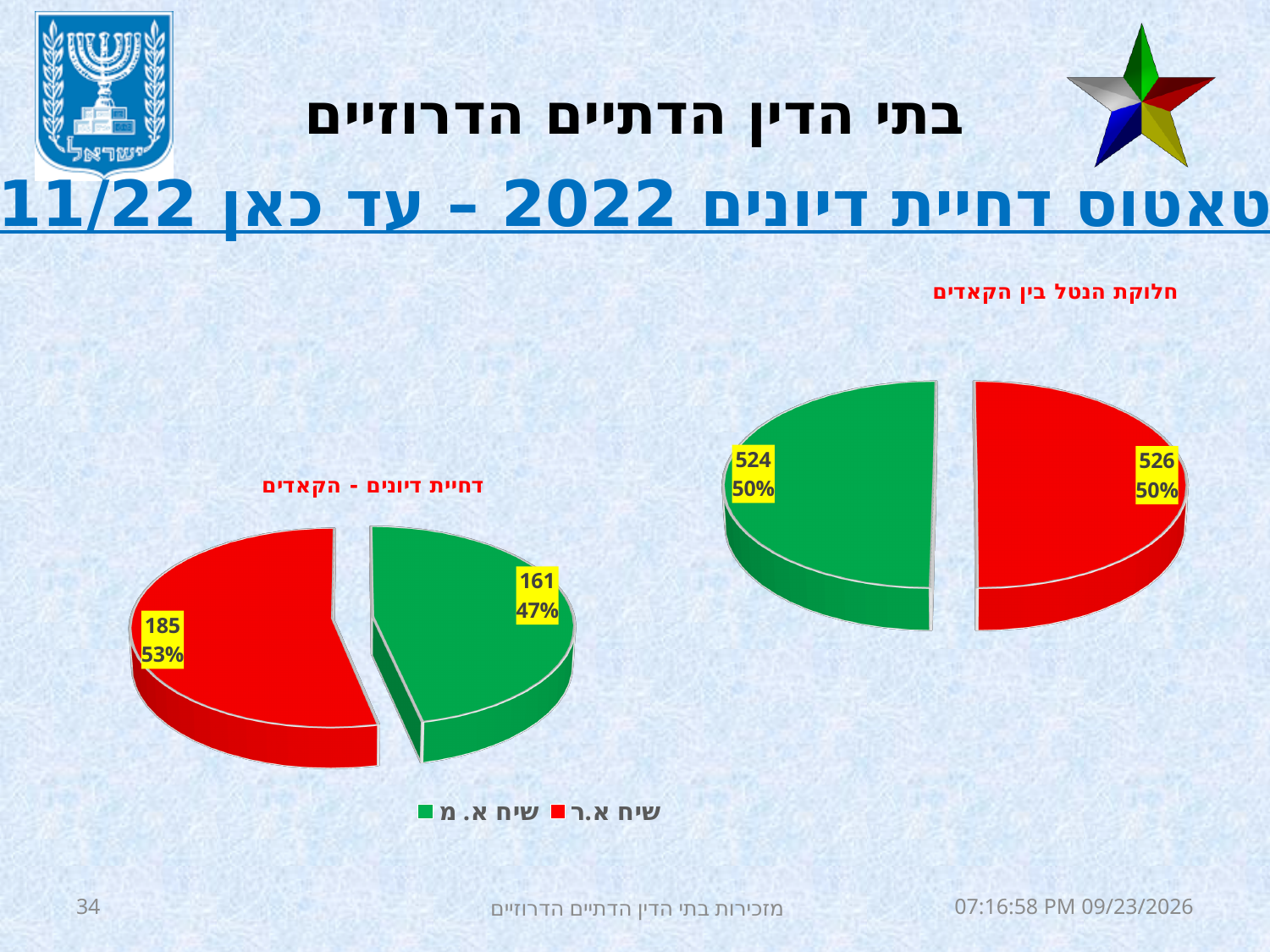
What kind of chart is the chart titled "חלוקת הנטל בין הקאדים"? Pie chart In the chart titled "חלוקת הנטל בין הקאדים", what is the total of the two slices? 1050 In the chart titled "דחיית דיונים - הקאדים", what value is shown for the red slice (שיח א.ר)? 185 In the chart titled "דחיית דיונים - הקאדים", which slice is larger, שיח א.ר or שיח א. מ? שיח א.ר In the chart titled "דחיית דיונים - הקאדים", what is the difference between the values for שיח א.ר and שיח א. מ? 24 In the chart titled "דחיית דיונים - הקאדים", what percentage is shown for the green slice (שיח א. מ)? 47% How many entries does the legend at the bottom of the slide list? 2 How many slices does the chart titled "דחיית דיונים - הקאדים" have? 2 In the chart titled "חלוקת הנטל בין הקאדים", what is the difference between the values for שיח א.ר and שיח א. מ? 2 In the chart titled "דחיית דיונים - הקאדים", what is the total of the two slices? 346